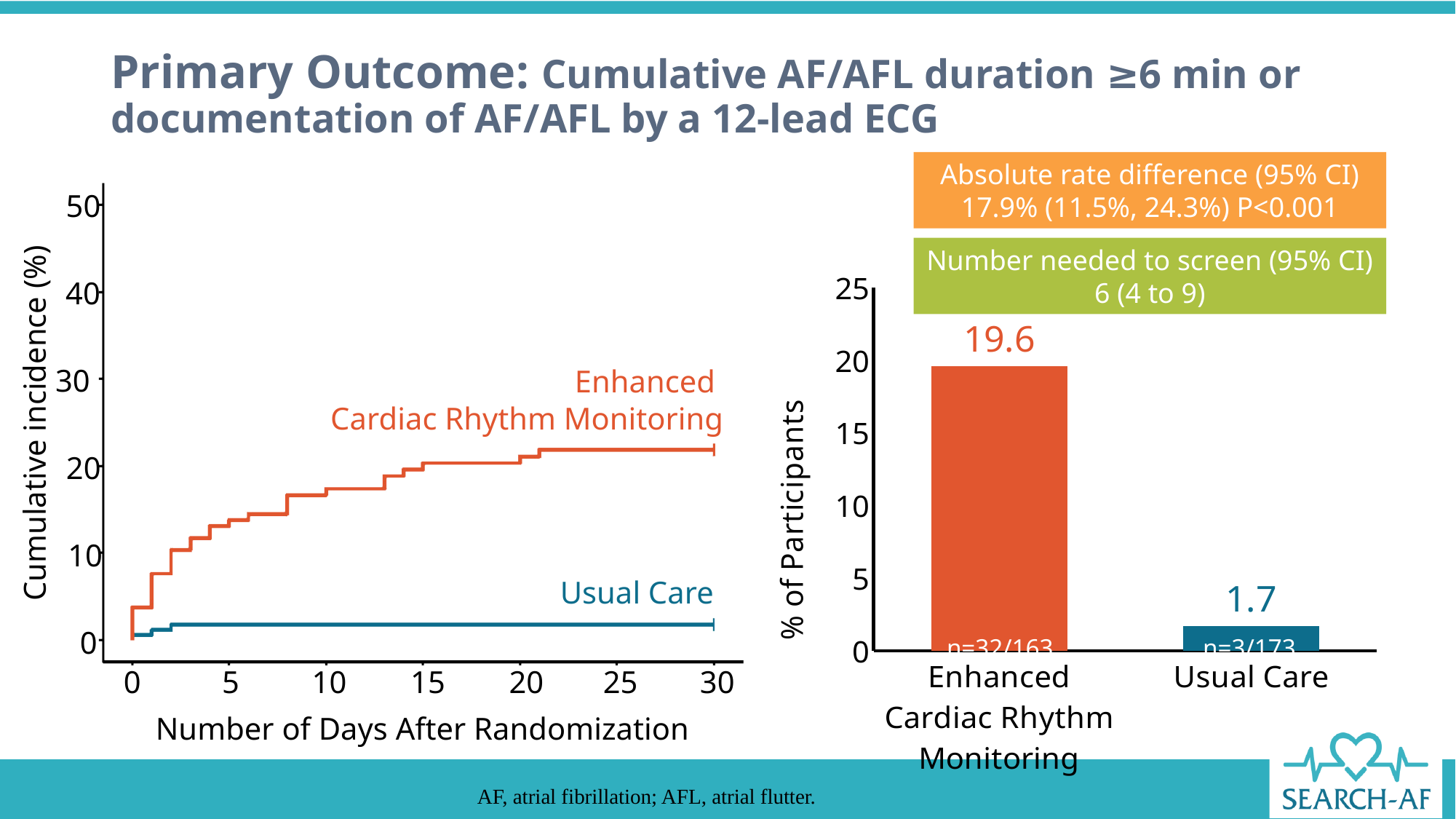
What kind of chart is the chart on the right of the slide? Bar chart In the cumulative incidence chart on the left, what is the label of the x axis? Number of Days After Randomization In the cumulative incidence chart on the left, does the Enhanced Cardiac Rhythm Monitoring line rise or fall as the number of days increases? Rise In the bar chart on the right, which group has the higher % of participants? Enhanced Cardiac Rhythm Monitoring In the bar chart on the right, what is the value for Enhanced Cardiac Rhythm Monitoring? 19.6 In the bar chart on the right, what is the difference between the Enhanced Cardiac Rhythm Monitoring value and the Usual Care value? 17.9 In the bar chart on the right, what is the value for Usual Care? 1.7 In the bar chart on the right, what is the n label printed on the Usual Care bar? n=3/173 In the bar chart on the right, how many bars are shown? 2 In the bar chart on the right, what is the n label printed on the Enhanced Cardiac Rhythm Monitoring bar? n=32/163 In the cumulative incidence chart on the left, is the value for Enhanced Cardiac Rhythm Monitoring at day 30 greater or less than 20? greater In the cumulative incidence chart on the left, is the value for Usual Care at day 30 greater or less than 10? less